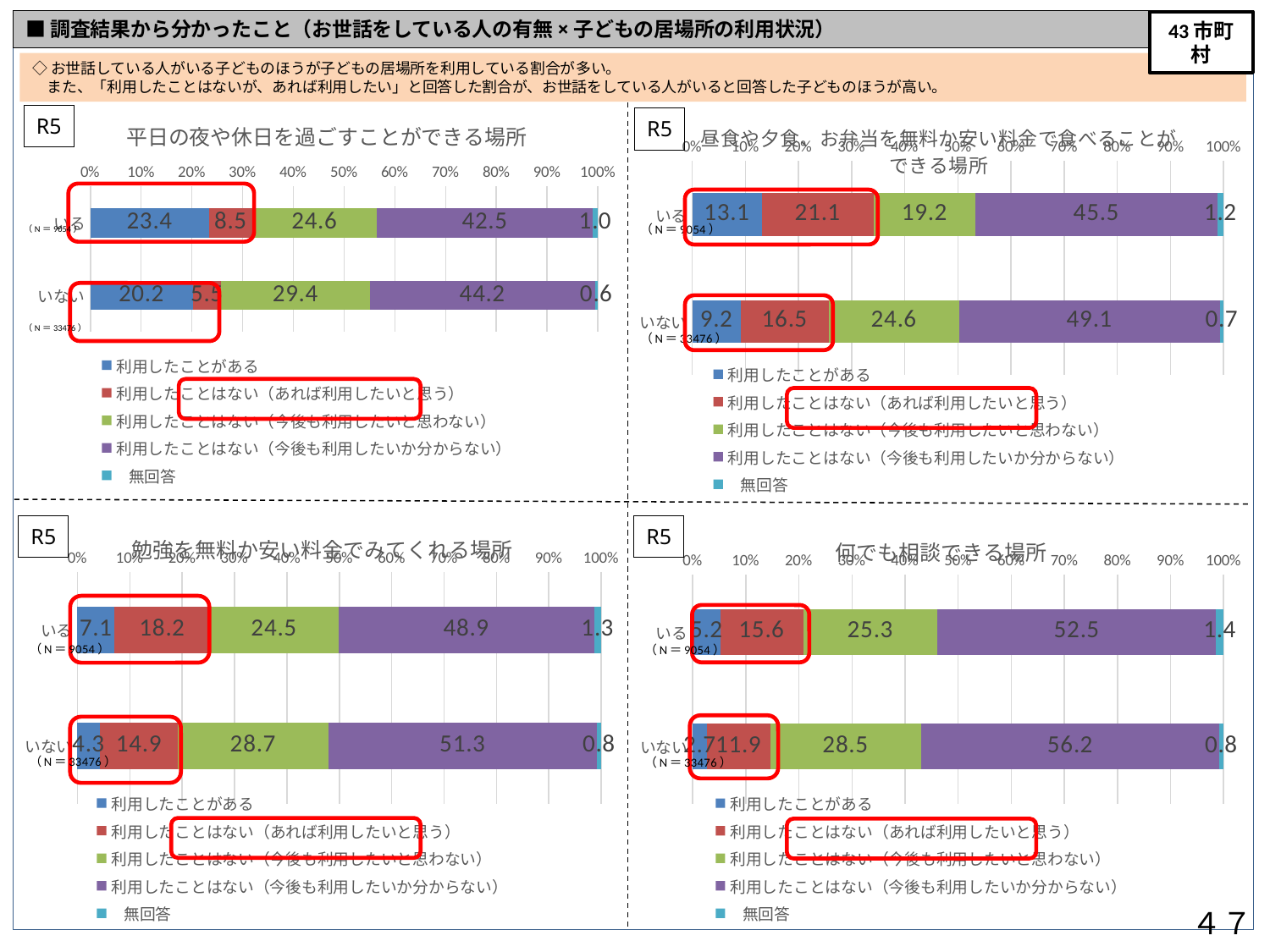
In the chart titled 「何でも相談できる場所」, which segment is the largest in the 「いる」 bar? 利用したことはない（今後も利用したいか分からない） How many categories (bars) are shown in the chart titled 「昼食や夕食、お弁当を無料か安い料金で食べることができる場所」? 2 In the chart titled 「平日の夜や休日を過ごすことができる場所」, what is the value of 「利用したことはない（あれば利用したいと思う）」 for the 「いない」 category? 5.5 In the chart titled 「昼食や夕食、お弁当を無料か安い料金で食べることができる場所」, what is the difference between the 「利用したことがある」 values for 「いる」 and 「いない」? 3.9 In the chart titled 「昼食や夕食、お弁当を無料か安い料金で食べることができる場所」, what is the value of 「利用したことはない（あれば利用したいと思う）」 for the 「いる」 category? 21.1 What kind of chart is the chart titled 「勉強を無料か安い料金でみてくれる場所」? Stacked bar chart In the chart titled 「平日の夜や休日を過ごすことができる場所」, what is the value of 「利用したことがある」 for the 「いる」 category? 23.4 In the chart titled 「勉強を無料か安い料金でみてくれる場所」, what is the value of 「利用したことはない（今後も利用したいか分からない）」 for the 「いない」 category? 51.3 In the chart titled 「勉強を無料か安い料金でみてくれる場所」, which category has the larger 「利用したことはない（あれば利用したいと思う）」 value, 「いる」 or 「いない」? いる In the chart titled 「何でも相談できる場所」, what is the difference between the 「利用したことはない（今後も利用したいか分からない）」 values for 「いない」 and 「いる」? 3.7 In the chart titled 「何でも相談できる場所」, what is the value of 「利用したことがある」 for the 「いない」 category? 2.7 How many series does the legend list in the chart titled 「平日の夜や休日を過ごすことができる場所」? 5